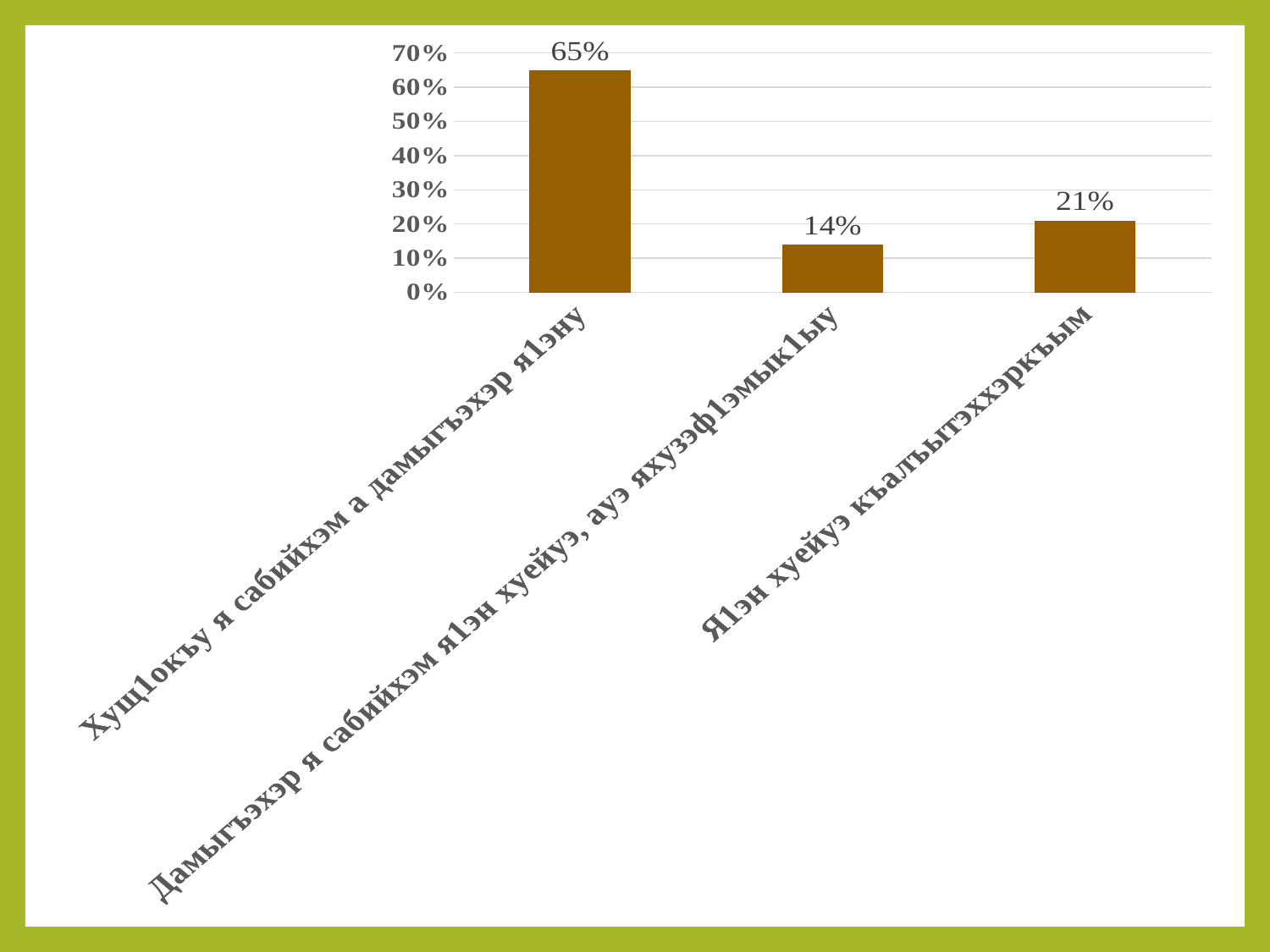
What is the difference between the values for "Я1эн хуейуэ къалъытэххэркъым" and "Дамыгъэхэр я сабийхэм я1эн хуейуэ, ауэ яхузэф1эмык1ыу"? 7% What kind of chart is shown on the slide? bar chart Is the value for "Хущ1окъу я сабийхэм а дамыгъэхэр я1эну" greater or less than 50%? greater Which is larger: the value for "Я1эн хуейуэ къалъытэххэркъым" or the value for "Дамыгъэхэр я сабийхэм я1эн хуейуэ, ауэ яхузэф1эмык1ыу"? Я1эн хуейуэ къалъытэххэркъым Which category has the lowest value? Дамыгъэхэр я сабийхэм я1эн хуейуэ, ауэ яхузэф1эмык1ыу How many categories are shown in the chart? 3 What is the value for the category "Хущ1окъу я сабийхэм а дамыгъэхэр я1эну"? 65% What is the value for the category "Дамыгъэхэр я сабийхэм я1эн хуейуэ, ауэ яхузэф1эмык1ыу"? 14% Which category has the highest value? Хущ1окъу я сабийхэм а дамыгъэхэр я1эну What is the difference between the values for "Хущ1окъу я сабийхэм а дамыгъэхэр я1эну" and "Я1эн хуейуэ къалъытэххэркъым"? 44% What is the highest value shown on the vertical axis? 70% What is the value for the category "Я1эн хуейуэ къалъытэххэркъым"? 21%